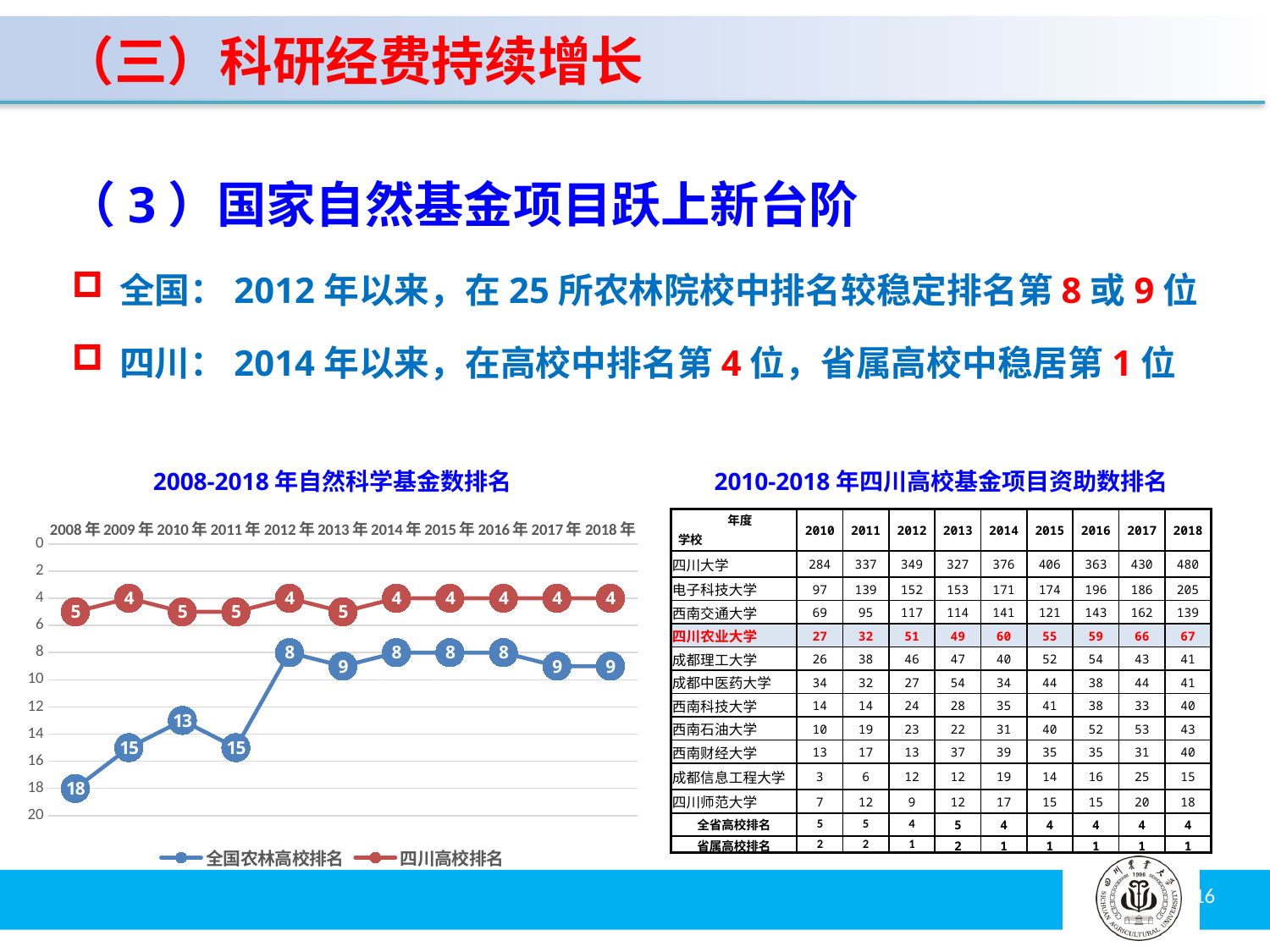
In the 2008-2018年自然科学基金数排名 chart, do the 全国农林高校排名 values overall rise or fall from 2008年 to 2018年? fall In the 2008-2018年自然科学基金数排名 chart, what is the difference between 全国农林高校排名 and 四川高校排名 in 2012年? 4 In the 2008-2018年自然科学基金数排名 chart, what is the value of 全国农林高校排名 for 2008年? 18 How many years are plotted along the x axis of the 2008-2018年自然科学基金数排名 chart? 11 In the 2008-2018年自然科学基金数排名 chart, what is the value of 全国农林高校排名 for 2018年? 9 In the 2008-2018年自然科学基金数排名 chart, which series has the larger value in 2009年, 全国农林高校排名 or 四川高校排名? 全国农林高校排名 In the 2008-2018年自然科学基金数排名 chart, which year has the largest value for 全国农林高校排名? 2008年 How many series does the legend of the 2008-2018年自然科学基金数排名 chart list? 2 In the 2008-2018年自然科学基金数排名 chart, what is the difference between the 全国农林高校排名 values for 2008年 and 2018年? 9 In the 2008-2018年自然科学基金数排名 chart, what is the value of 全国农林高校排名 for 2010年? 13 What type of chart is shown under the title 2008-2018年自然科学基金数排名? line chart In the 2008-2018年自然科学基金数排名 chart, what is the value of 四川高校排名 for 2013年? 5